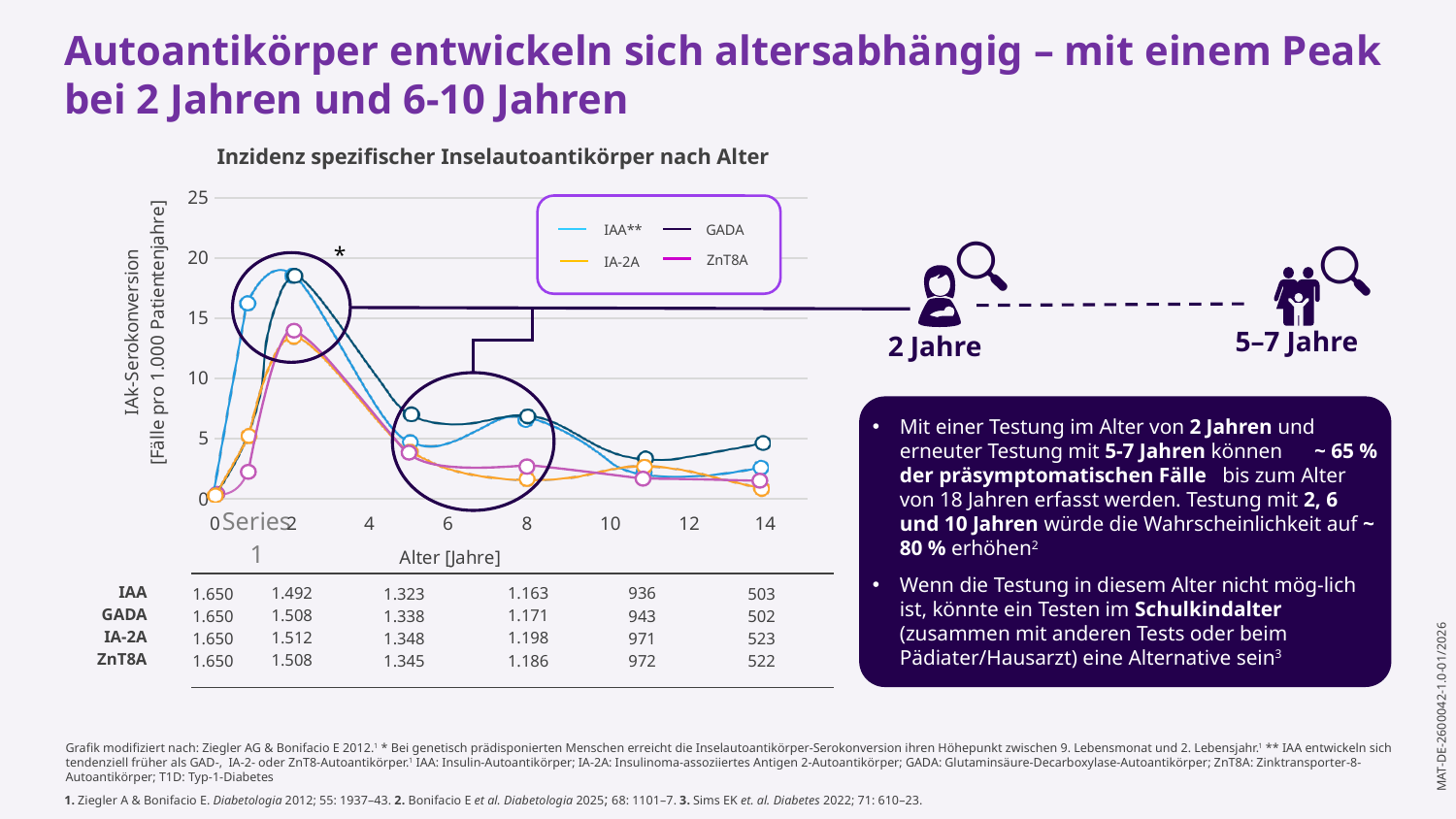
Is the value for IA-2A at age 2 greater or less than 15? less Is the value for GADA at age 2 greater or less than 15? greater Is the value for IAA** at age 2 greater or less than 15? greater How many series does the chart legend list? 4 Does the IAA** line rise or fall between age 2 and age 5? fall What kind of chart is shown on the slide? line chart How many tick marks are labelled on the x axis of the chart? 8 What is the label of the x axis of the chart? Alter [Jahre] What is the title of the chart? Inzidenz spezifischer Inselautoantikörper nach Alter